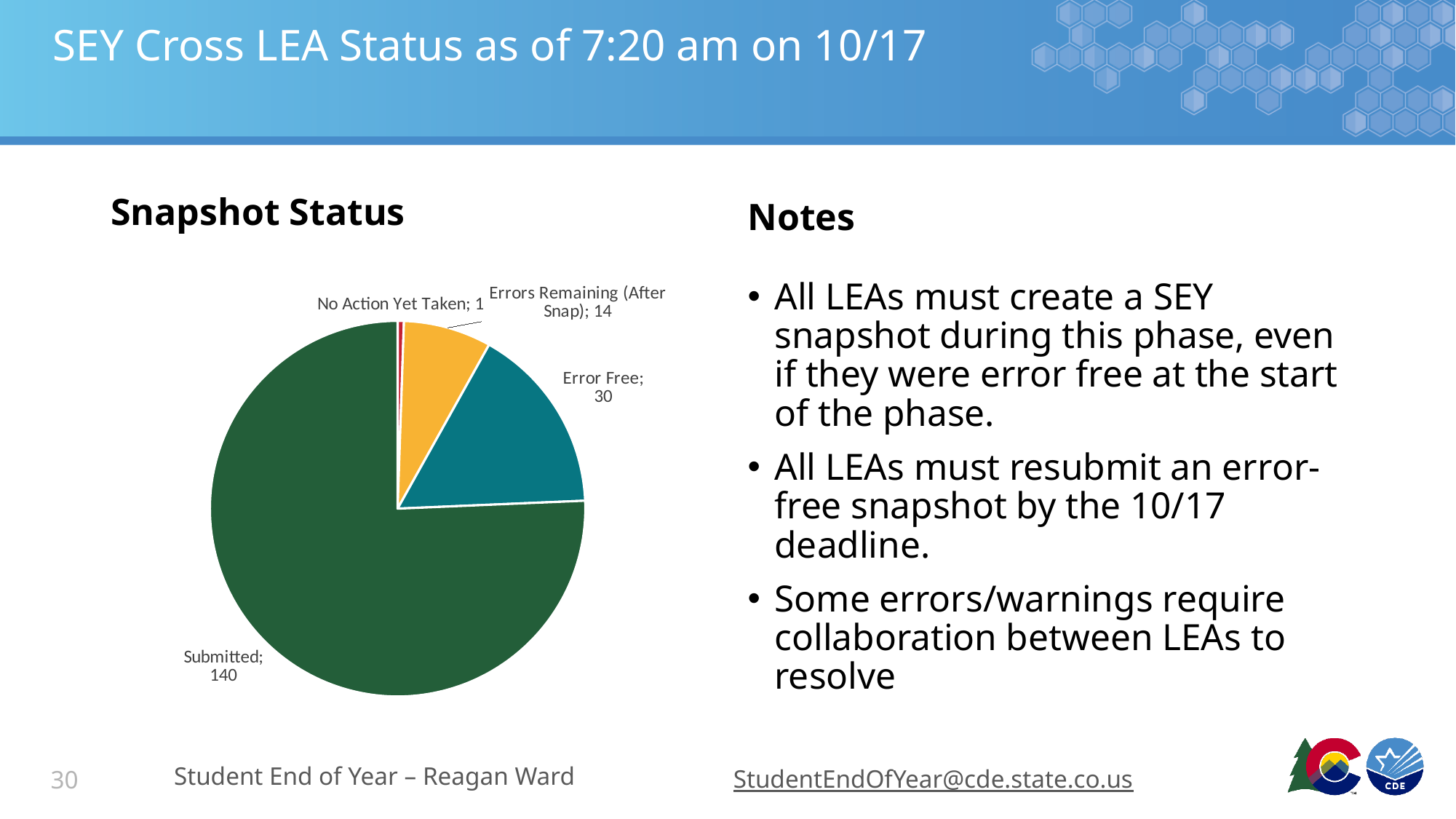
What colour is the Submitted slice in the Snapshot Status pie chart? Dark green How many categories are shown in the Snapshot Status pie chart? 4 How many LEAs are in the Submitted category of the Snapshot Status pie chart? 140 What is the value for Error Free in the Snapshot Status pie chart? 30 Which category has the largest slice in the Snapshot Status pie chart? Submitted What type of chart is shown under the heading Snapshot Status? Pie chart What is the value for Errors Remaining (After Snap) in the Snapshot Status pie chart? 14 Which is larger in the Snapshot Status pie chart, Error Free or Errors Remaining (After Snap)? Error Free What is the difference between the Submitted and Error Free values in the Snapshot Status pie chart? 110 What is the value for No Action Yet Taken in the Snapshot Status pie chart? 1 Which category has the smallest slice in the Snapshot Status pie chart? No Action Yet Taken What is the total of all slices in the Snapshot Status pie chart? 185